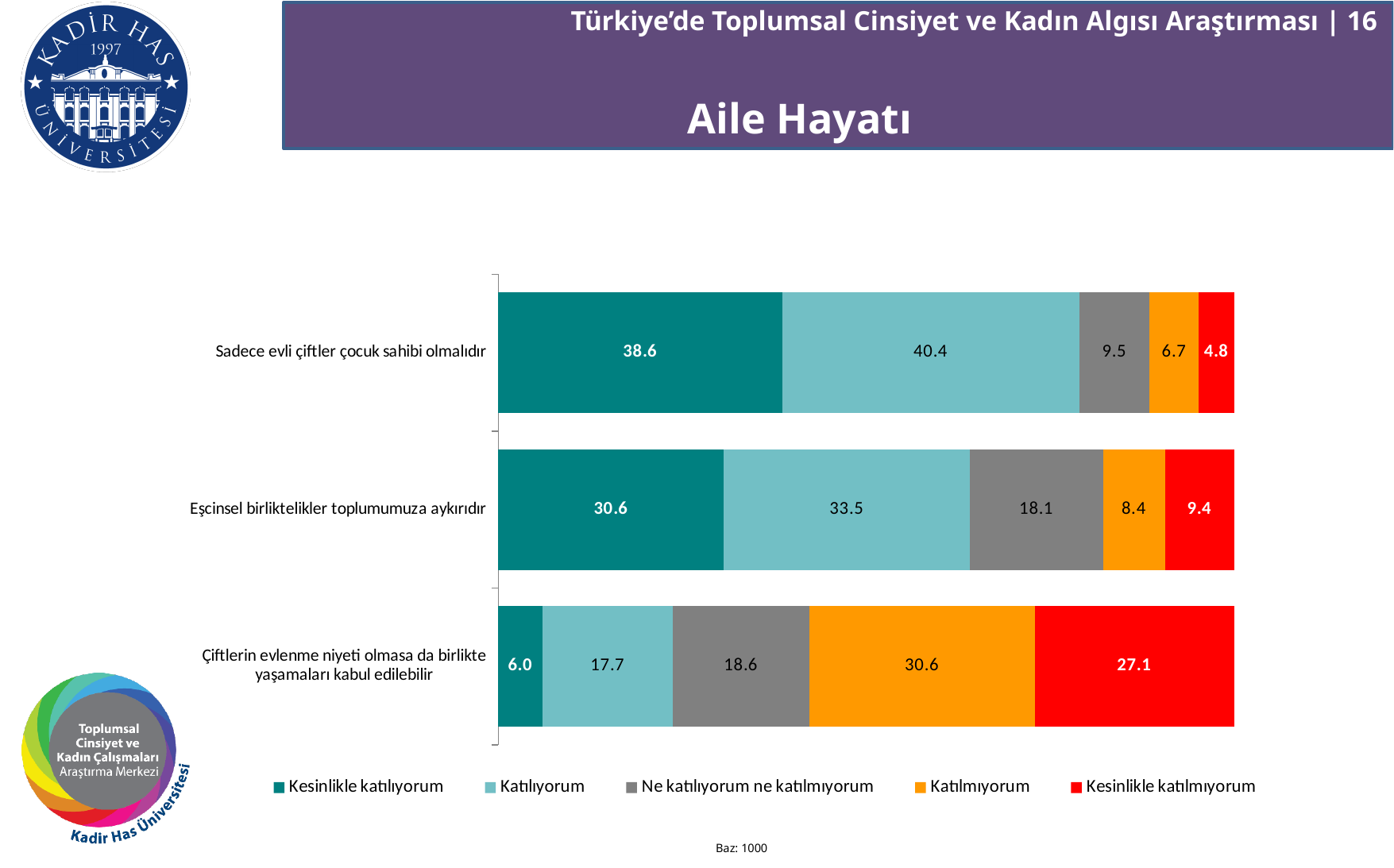
What is the value of "Ne katılıyorum ne katılmıyorum" for "Eşcinsel birliktelikler toplumumuza aykırıdır"? 18.1 What colour represents "Kesinlikle katılmıyorum" in the legend? Red What is the value of "Kesinlikle katılmıyorum" for "Çiftlerin evlenme niyeti olmasa da birlikte yaşamaları kabul edilebilir"? 27.1 What is the difference between the "Katılmıyorum" value and the "Kesinlikle katılıyorum" value for "Çiftlerin evlenme niyeti olmasa da birlikte yaşamaları kabul edilebilir"? 24.6 What is the value of "Kesinlikle katılıyorum" for "Sadece evli çiftler çocuk sahibi olmalıdır"? 38.6 What kind of chart is shown on the slide? Stacked bar chart How many series does the legend list? 5 How many statements (categories) are shown in the chart? 3 What is the total of the stacked bar for "Eşcinsel birliktelikler toplumumuza aykırıdır"? 100.0 Which statement has the highest "Kesinlikle katılıyorum" value? Sadece evli çiftler çocuk sahibi olmalıdır Which is larger for "Eşcinsel birliktelikler toplumumuza aykırıdır": "Katılmıyorum" or "Kesinlikle katılmıyorum"? Kesinlikle katılmıyorum Which statement has the lowest "Katılıyorum" value? Çiftlerin evlenme niyeti olmasa da birlikte yaşamaları kabul edilebilir